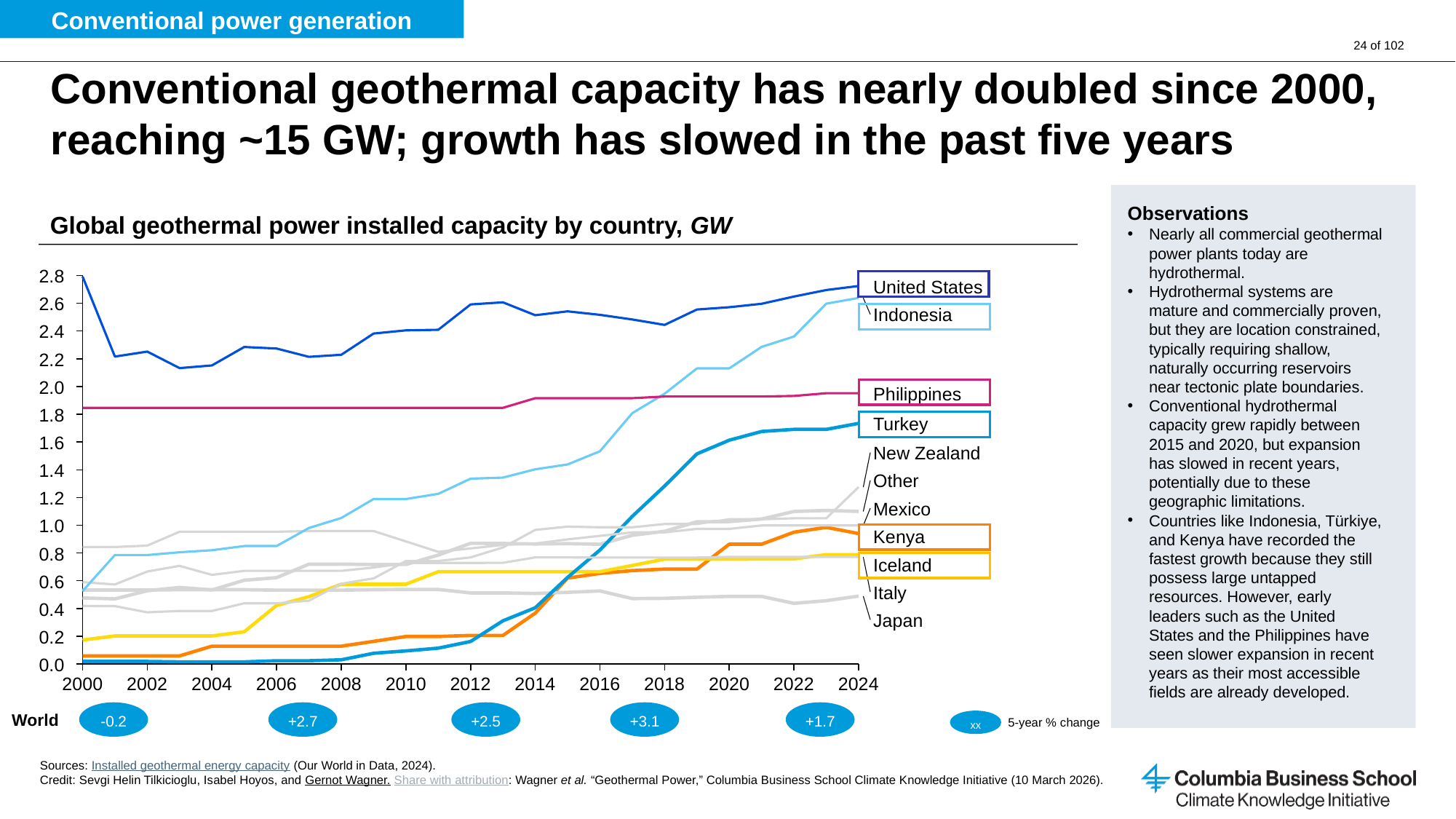
In what unit is installed geothermal capacity measured on the chart? GW Is Turkey's installed geothermal capacity in 2024 greater or less than 1.6 GW? greater Is Indonesia's installed geothermal capacity in 2000 greater or less than 1.0 GW? less What is the first World 5-year % change value shown below the chart? -0.2 What is the largest World 5-year % change value shown below the chart? +3.1 What kind of chart is used to show global geothermal power installed capacity by country? line chart Is Kenya's installed geothermal capacity in 2024 greater or less than 0.8 GW? greater Which country had the highest installed geothermal capacity in 2000? United States In 2024, which has the larger installed geothermal capacity, the Philippines or Turkey? Philippines How many countries or groups are labelled as series on the geothermal capacity chart? 11 Does Turkey's installed geothermal capacity rise or fall between 2000 and 2024? rise What is the difference between the largest and smallest World 5-year % change values shown? 3.3